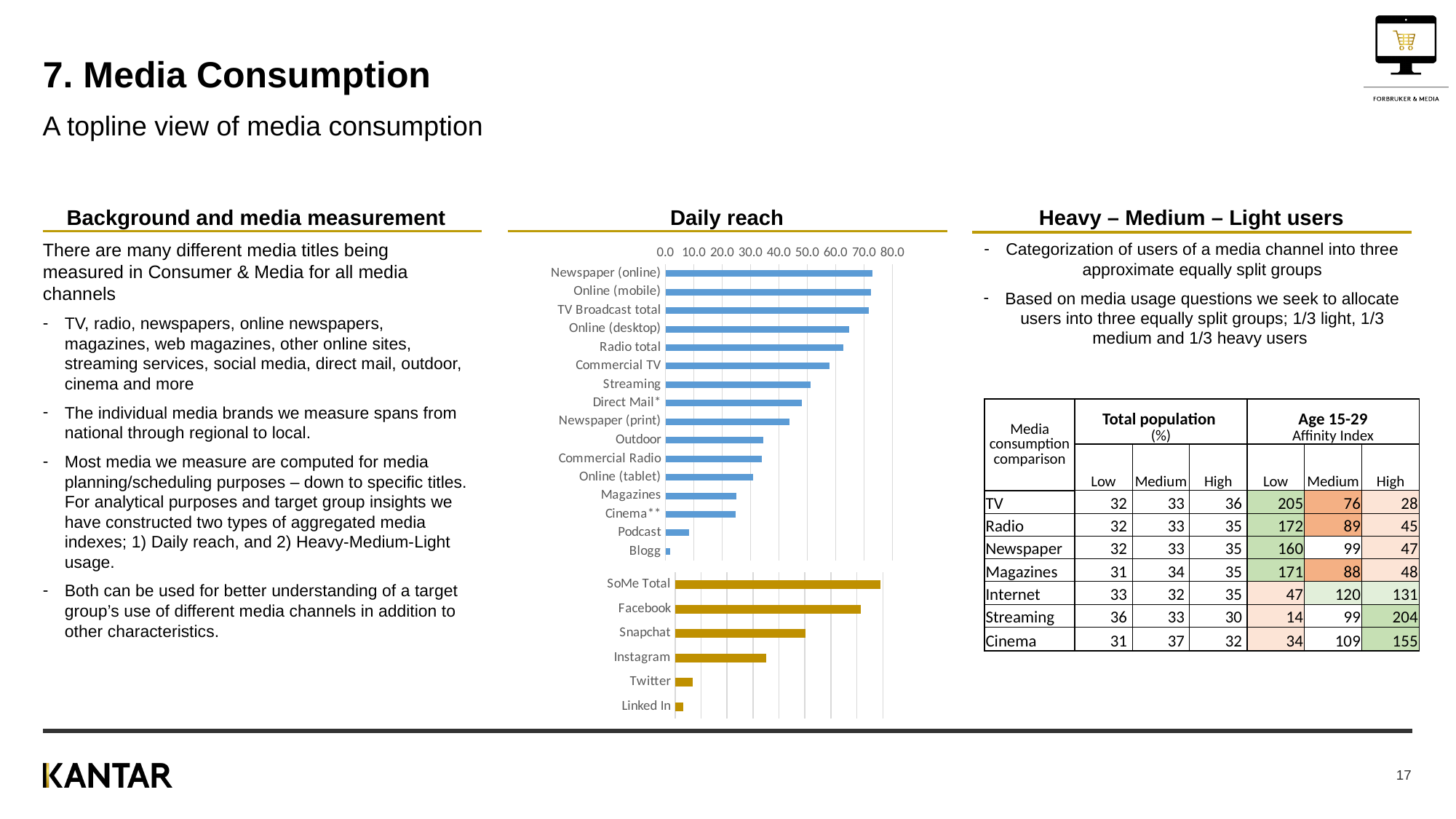
In the Daily reach chart, which is larger, Commercial TV or Streaming? Commercial TV In the Daily reach chart (top, blue bars), which category has the lowest value? Blogg In the Daily reach chart, is the value for Outdoor greater or less than 40.0? less In the bottom chart with gold bars (social media), which category has the lowest value? Linked In What kind of chart is the Daily reach chart? bar chart In the Daily reach chart, is the value for Newspaper (print) greater or less than 50.0? less In the Daily reach chart, what is the highest value shown on the horizontal axis? 80.0 In the bottom chart with gold bars (social media), which is larger, Facebook or Snapchat? Facebook In the bottom chart with gold bars (social media), which category has the highest value? SoMe Total In the Daily reach chart (top, blue bars), how many media categories are plotted? 16 In the bottom chart with gold bars (social media), how many categories are plotted? 6 In the Daily reach chart, is the value for Online (desktop) greater or less than 60.0? greater